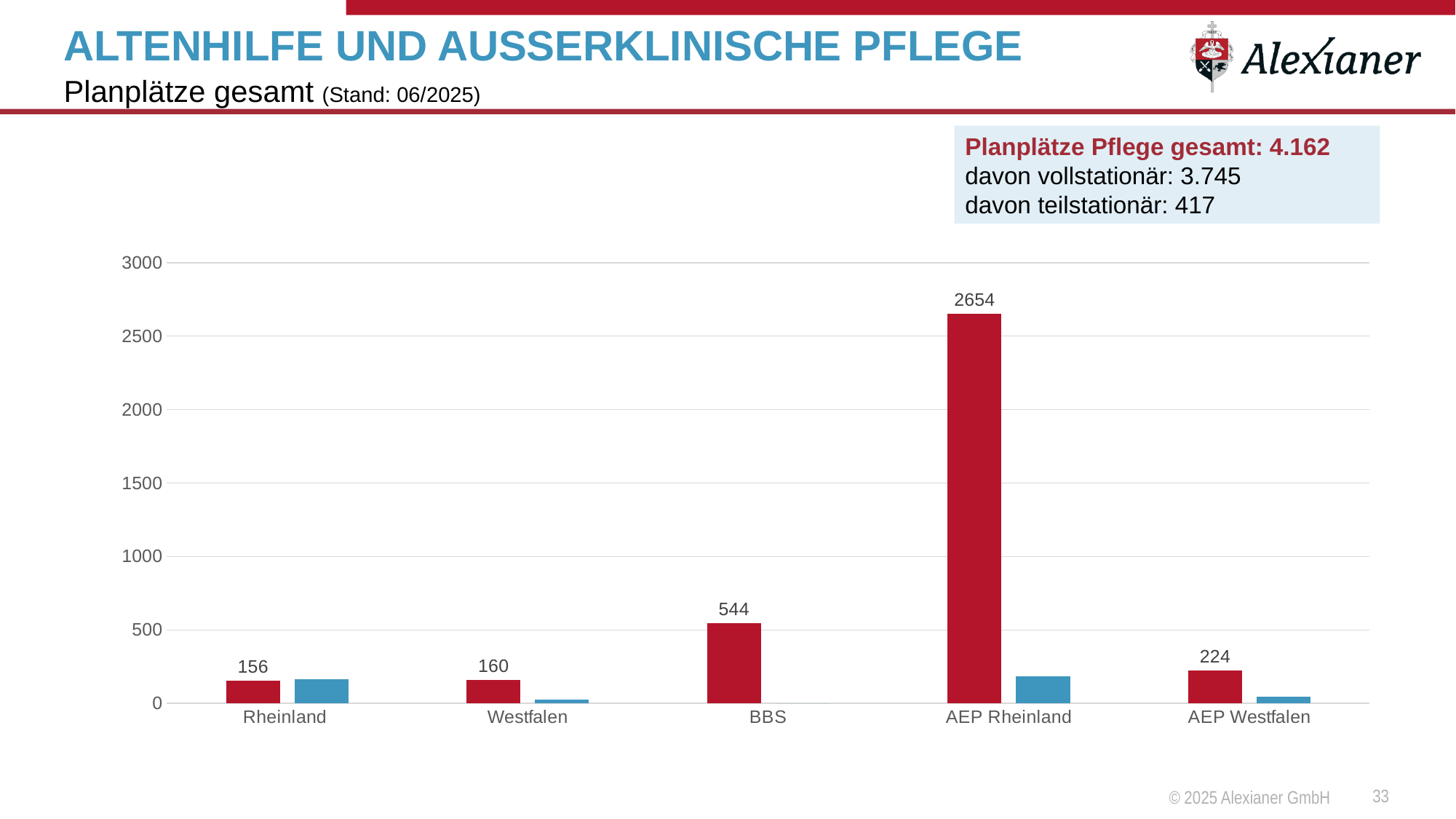
What is the value of the red bar for Rheinland? 156 What type of chart is shown on the slide? bar chart What is the difference between the red bar values for AEP Rheinland and BBS? 2110 Which category has the lowest labelled red bar? Rheinland What is the value of the red bar for AEP Rheinland? 2654 Which category has the highest red bar? AEP Rheinland According to the text box on the slide, what is the total number of Planplätze Pflege gesamt? 4.162 Is the value of the blue bar for AEP Rheinland greater or less than 500? less How many categories are shown on the x axis of the chart? 5 What is the value of the red bar for BBS? 544 What is the value of the red bar for AEP Westfalen? 224 Which red bar is larger, AEP Westfalen or Westfalen? AEP Westfalen